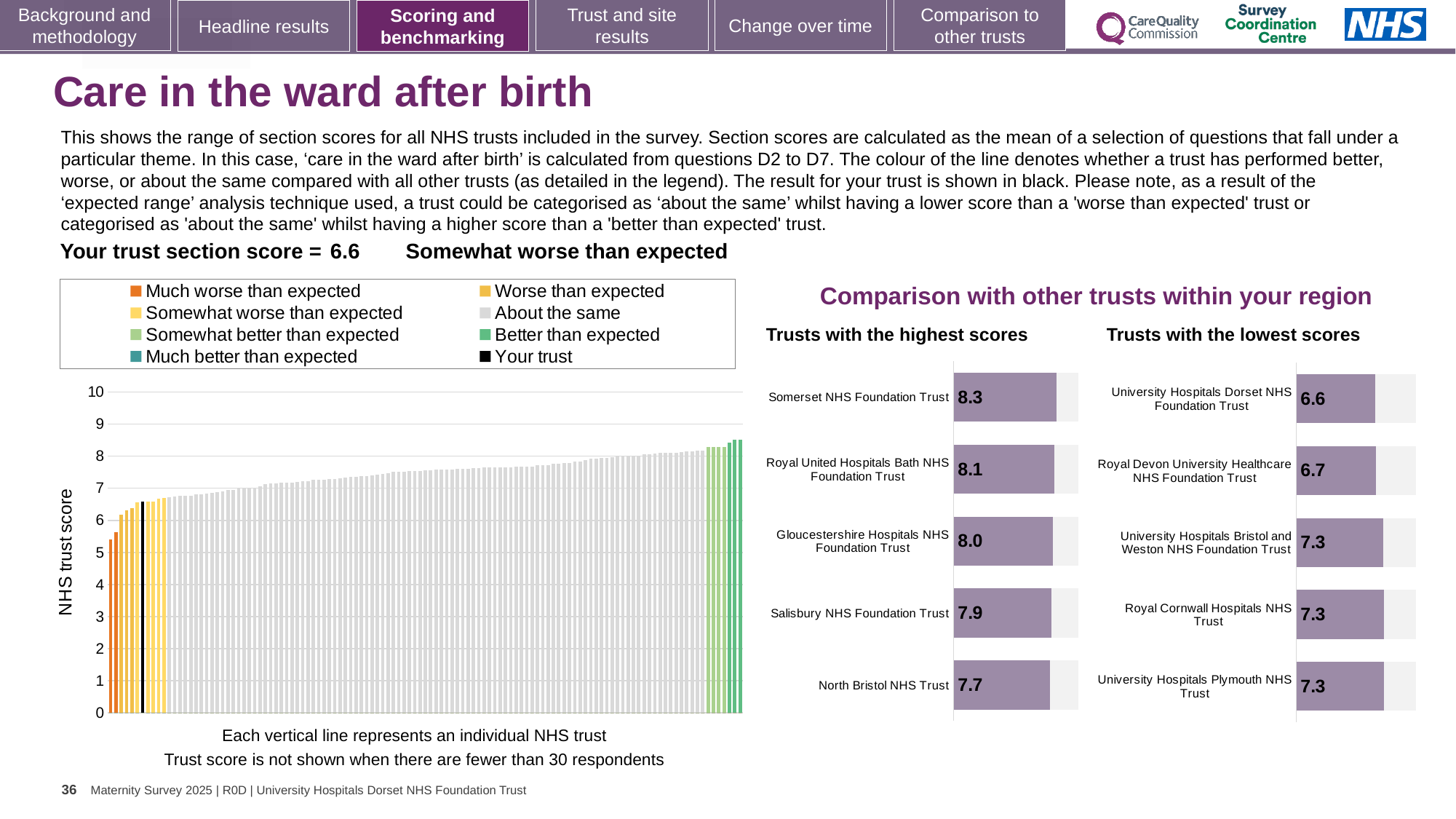
In the 'Trusts with the highest scores' chart, what is the score for North Bristol NHS Trust? 7.7 In the 'Trusts with the highest scores' chart, what is the score for Somerset NHS Foundation Trust? 8.3 In the 'Trusts with the highest scores' chart, what is the difference between the scores of Somerset NHS Foundation Trust and North Bristol NHS Trust? 0.6 In the 'Trusts with the lowest scores' chart, which has the larger score: University Hospitals Plymouth NHS Trust or Royal Devon University Healthcare NHS Foundation Trust? University Hospitals Plymouth NHS Trust What kind of chart is the large chart on the left showing NHS trust scores? Bar chart In the 'Trusts with the lowest scores' chart, what is the score for Royal Devon University Healthcare NHS Foundation Trust? 6.7 How many entries does the legend above the large chart on the left list? 8 In the 'Trusts with the highest scores' chart, how many trusts are shown? 5 In the 'Trusts with the lowest scores' chart, which trust has the lowest score? University Hospitals Dorset NHS Foundation Trust In the large chart on the left, do the trust scores rise or fall from left to right? Rise In the 'Trusts with the lowest scores' chart, what is the difference between the scores of Royal Cornwall Hospitals NHS Trust and University Hospitals Dorset NHS Foundation Trust? 0.7 In the 'Trusts with the highest scores' chart, which trust has the highest score? Somerset NHS Foundation Trust